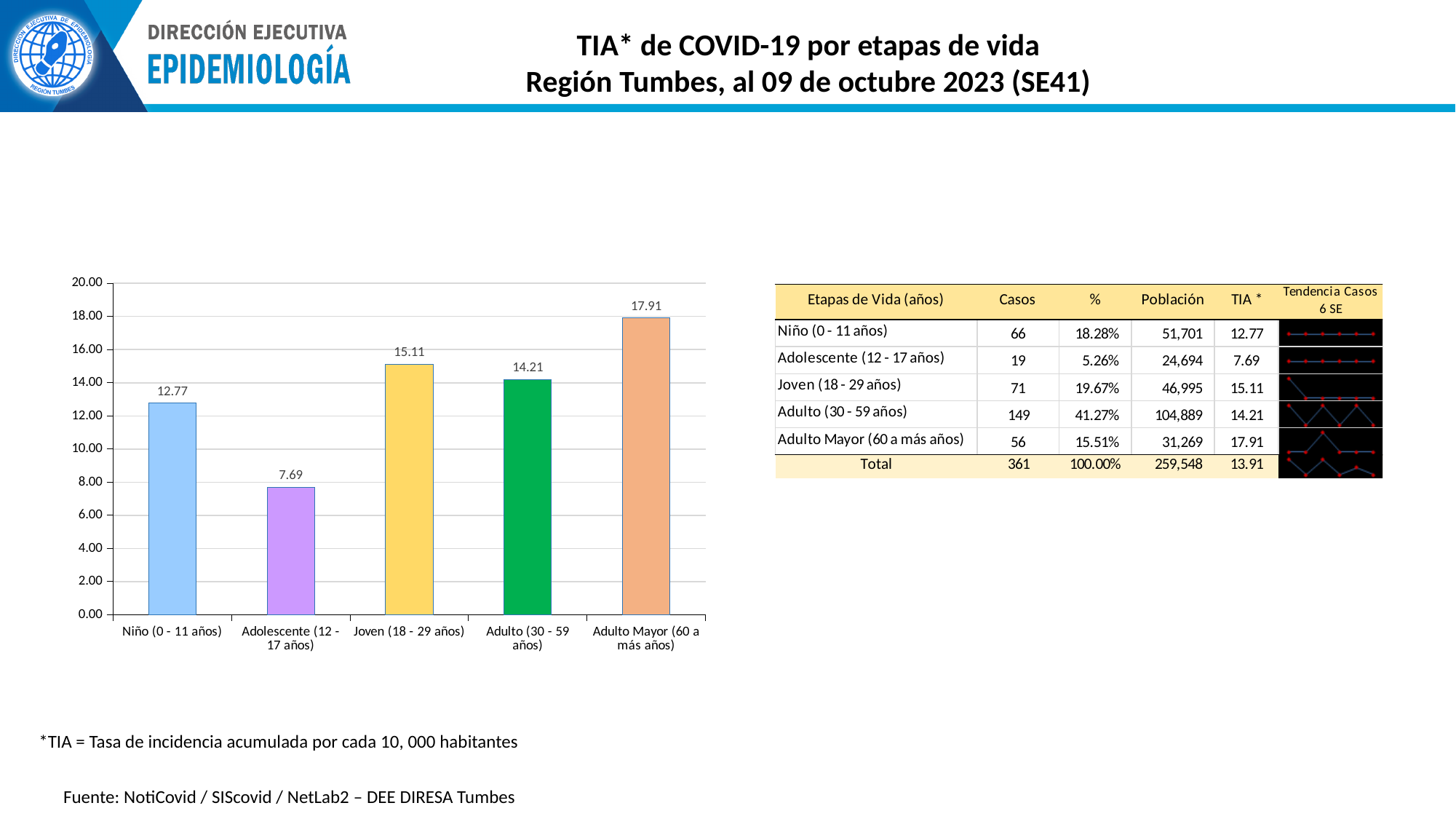
What is the TIA value for Adolescente (12 - 17 años) in the bar chart? 7.69 What is the difference between the TIA for Joven (18 - 29 años) and Adulto (30 - 59 años)? 0.90 What is the difference between the TIA for Adulto Mayor (60 a más años) and Adolescente (12 - 17 años)? 10.22 What is the TIA value for Joven (18 - 29 años) in the bar chart? 15.11 What is the TIA value for Niño (0 - 11 años) in the bar chart? 12.77 What is the TIA value for Adulto Mayor (60 a más años) in the bar chart? 17.91 What kind of chart is used to show TIA by life stage? bar chart Which life stage has the highest TIA in the bar chart? Adulto Mayor (60 a más años) Is the TIA value for Niño (0 - 11 años) greater or less than 14.00? less How many life-stage categories are shown in the bar chart? 5 Which has a higher TIA, Joven (18 - 29 años) or Adulto (30 - 59 años)? Joven (18 - 29 años) Which life stage has the lowest TIA in the bar chart? Adolescente (12 - 17 años)